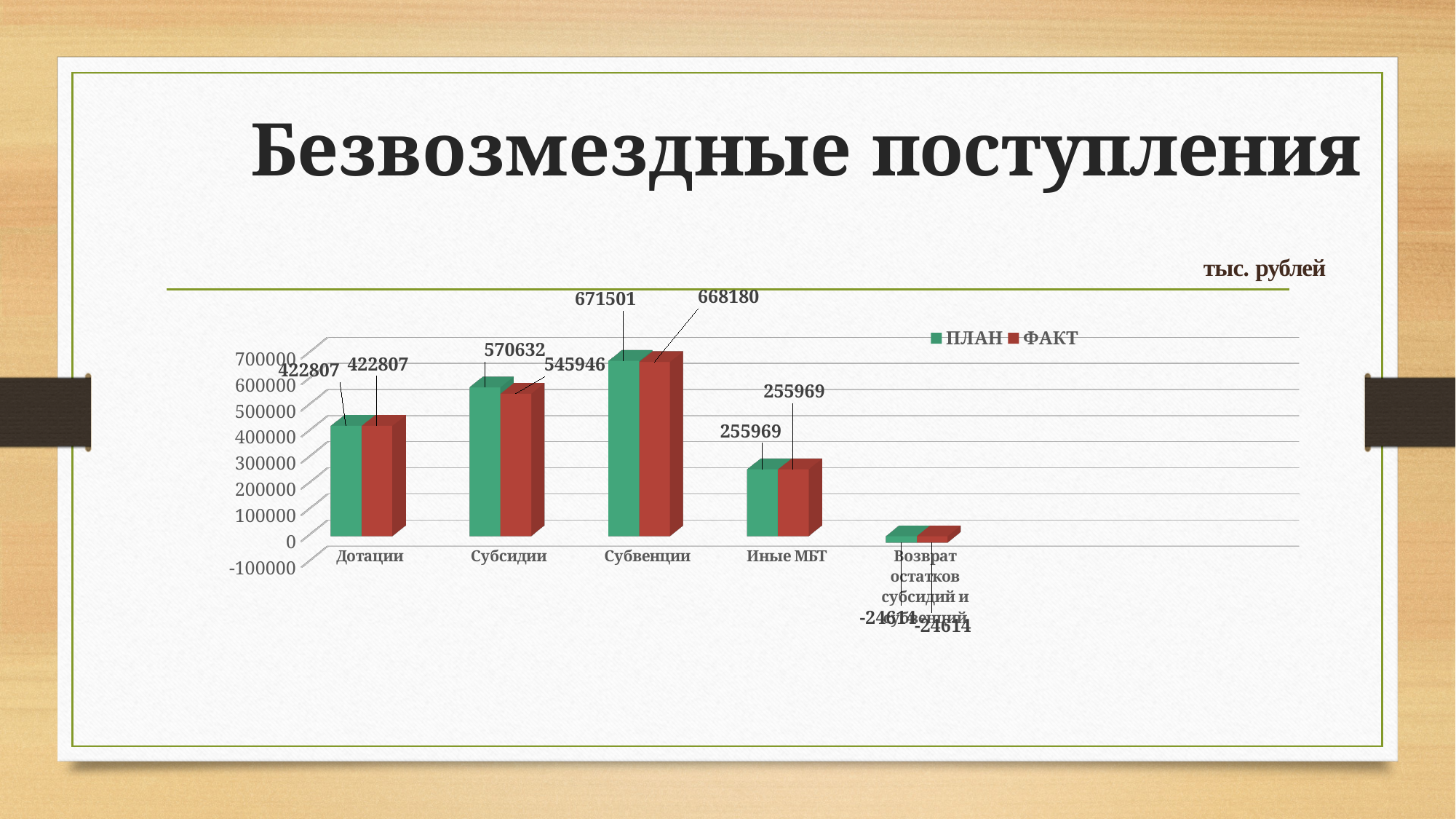
Which is larger for Субсидии, the ПЛАН value or the ФАКТ value? ПЛАН What is the ФАКТ value for Субвенции? 668180 Which category has the highest ПЛАН value? Субвенции What is the ПЛАН value for Иные МБТ? 255969 What is the difference between the ПЛАН and ФАКТ values for Субвенции? 3321 How many categories are shown on the x axis? 5 What is the difference between the ПЛАН and ФАКТ values for Субсидии? 24686 What is the ФАКТ value for Дотации? 422807 Which category has the lowest ФАКТ value? Возврат остатков субсидий и субвенций What type of chart is shown on the slide? Bar chart What is the ПЛАН value for Субсидии? 570632 How many series does the legend list? 2